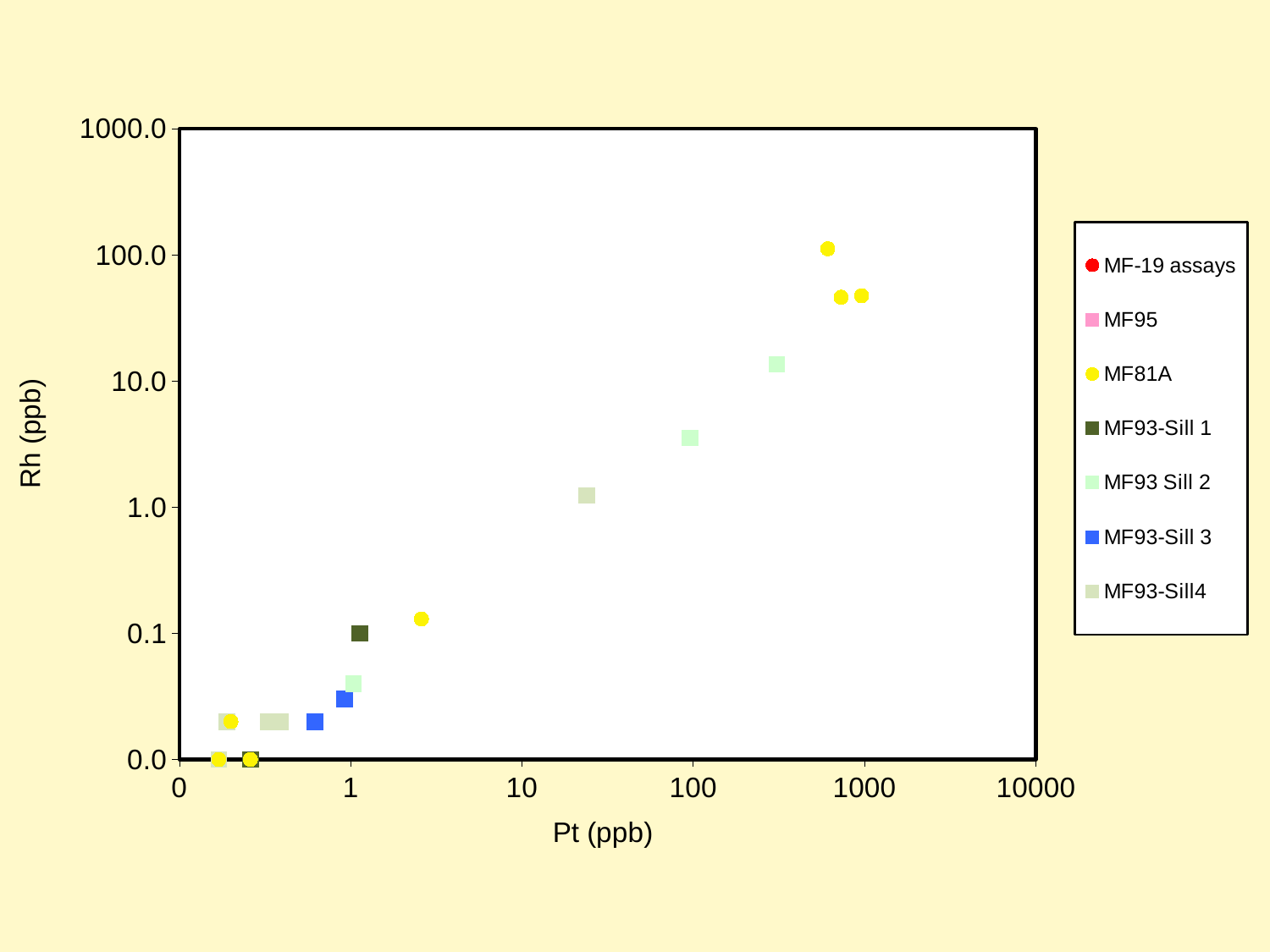
Which series has the point with the highest Rh (ppb) value? MF81A What is the label of the y axis? Rh (ppb) Do the Rh (ppb) values generally rise or fall as Pt (ppb) increases along the x axis? rise Is the Rh (ppb) value of the highest MF93 Sill 2 point greater or less than 10? greater How many MF93-Sill 3 points are plotted? 2 How many MF93 Sill 2 points are plotted? 3 How many series does the legend list? 7 What kind of chart is shown on the slide? scatter chart What is the label of the x axis? Pt (ppb) How many MF81A points are plotted? 7 Is the Pt (ppb) value of the rightmost MF81A point greater or less than 100? greater Which series reaches a higher Rh (ppb) value, MF93 Sill 2 or MF93-Sill4? MF93 Sill 2